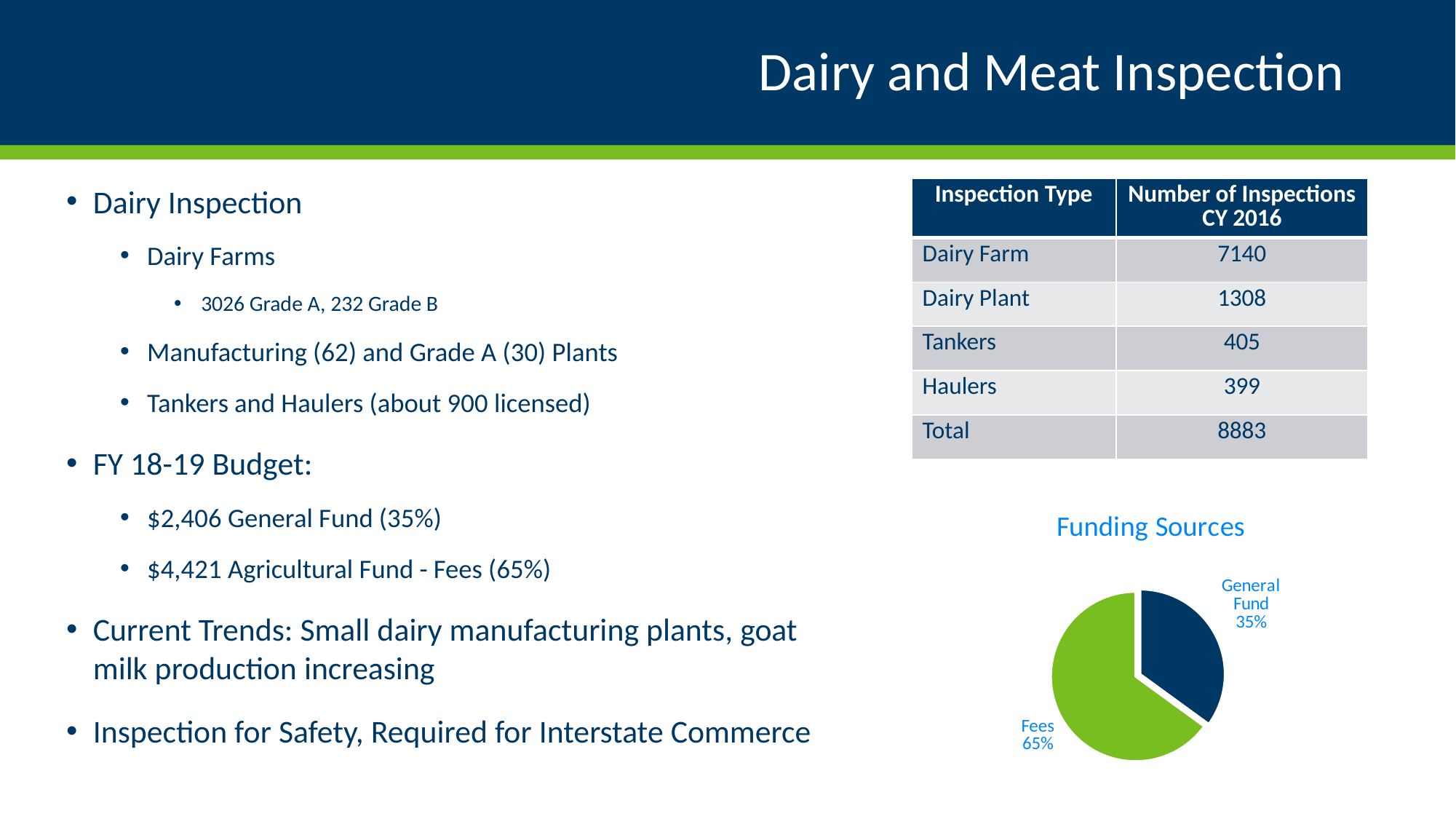
How many slices does the Funding Sources pie chart have? 2 In the Funding Sources pie chart, is the Fees share greater or less than 50%? greater Which slice is the largest in the Funding Sources pie chart? Fees In the Funding Sources pie chart, what colour is the Fees slice? green In the Funding Sources pie chart, what share does General Fund account for? 35% In the Funding Sources pie chart, what share does Fees account for? 65% In the Funding Sources pie chart, what is the difference in percentage points between the Fees share and the General Fund share? 30 What kind of chart is shown under the title "Funding Sources"? pie chart Which slice is the smallest in the Funding Sources pie chart? General Fund In the Funding Sources pie chart, which is larger, Fees or General Fund? Fees What is the title of the pie chart on the slide? Funding Sources